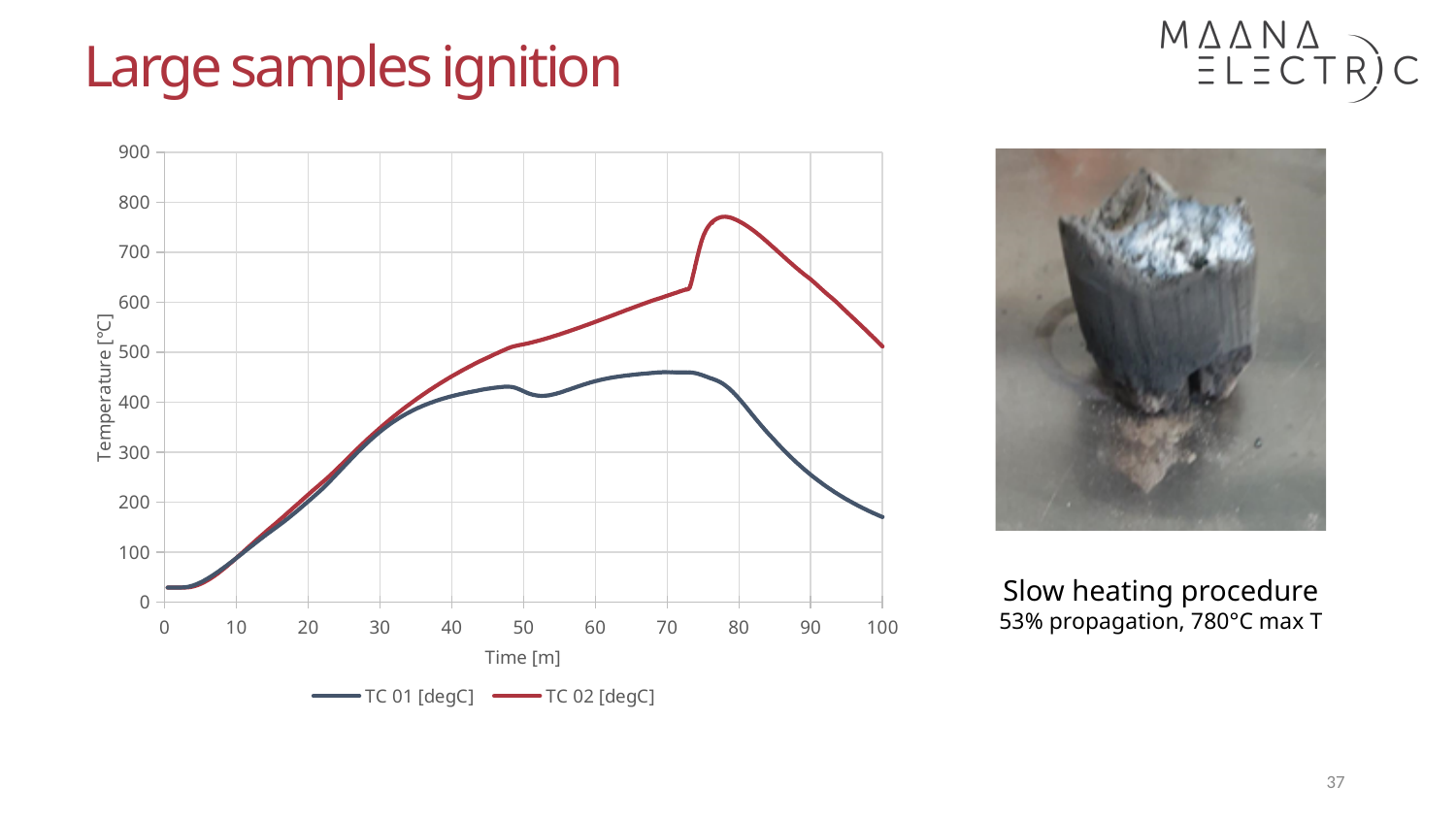
At time 80, which series has the higher temperature, TC 01 or TC 02? TC 02 Does the TC 02 series rise or fall between time 80 and time 100? fall Is the peak value of TC 02 greater or less than 700? greater Does the TC 01 series rise or fall between time 0 and time 40? rise Is the value of TC 02 at time 60 greater or less than 500? greater What is the label of the chart's x axis? Time [m] Is the peak value of TC 01 greater or less than 500? less What are the two series named in the chart legend? TC 01 [degC] and TC 02 [degC] How many series does the chart legend list? 2 Which series reaches the higher peak temperature, TC 01 or TC 02? TC 02 What kind of chart is shown on the slide? line chart